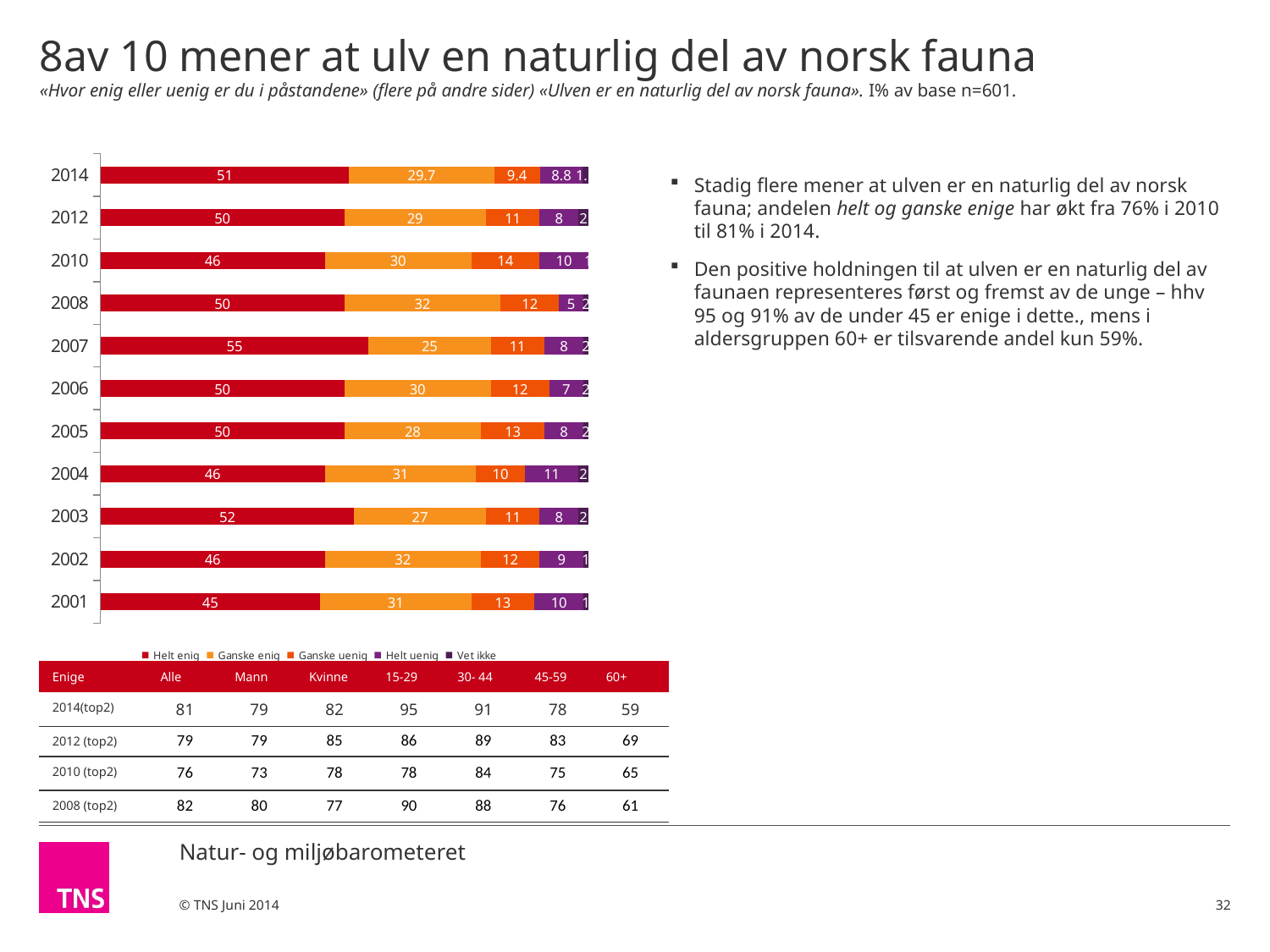
How many series does the legend list? 5 How many years are shown on the chart? 11 What kind of chart is shown on the slide? Stacked bar chart Which is larger, the Ganske enig value for 2010 or for 2012? 2010 What is the value of Ganske uenig for 2010? 14 What is the value of Helt enig for 2007? 55 What is the value of Ganske enig for 2008? 32 Which year has the lowest value for Helt enig? 2001 What is the total of the stacked bar for 2012? 100 Which year has the highest value for Helt enig? 2007 What is the difference between the Helt enig values for 2007 and 2001? 10 What is the value of Helt uenig for 2004? 11